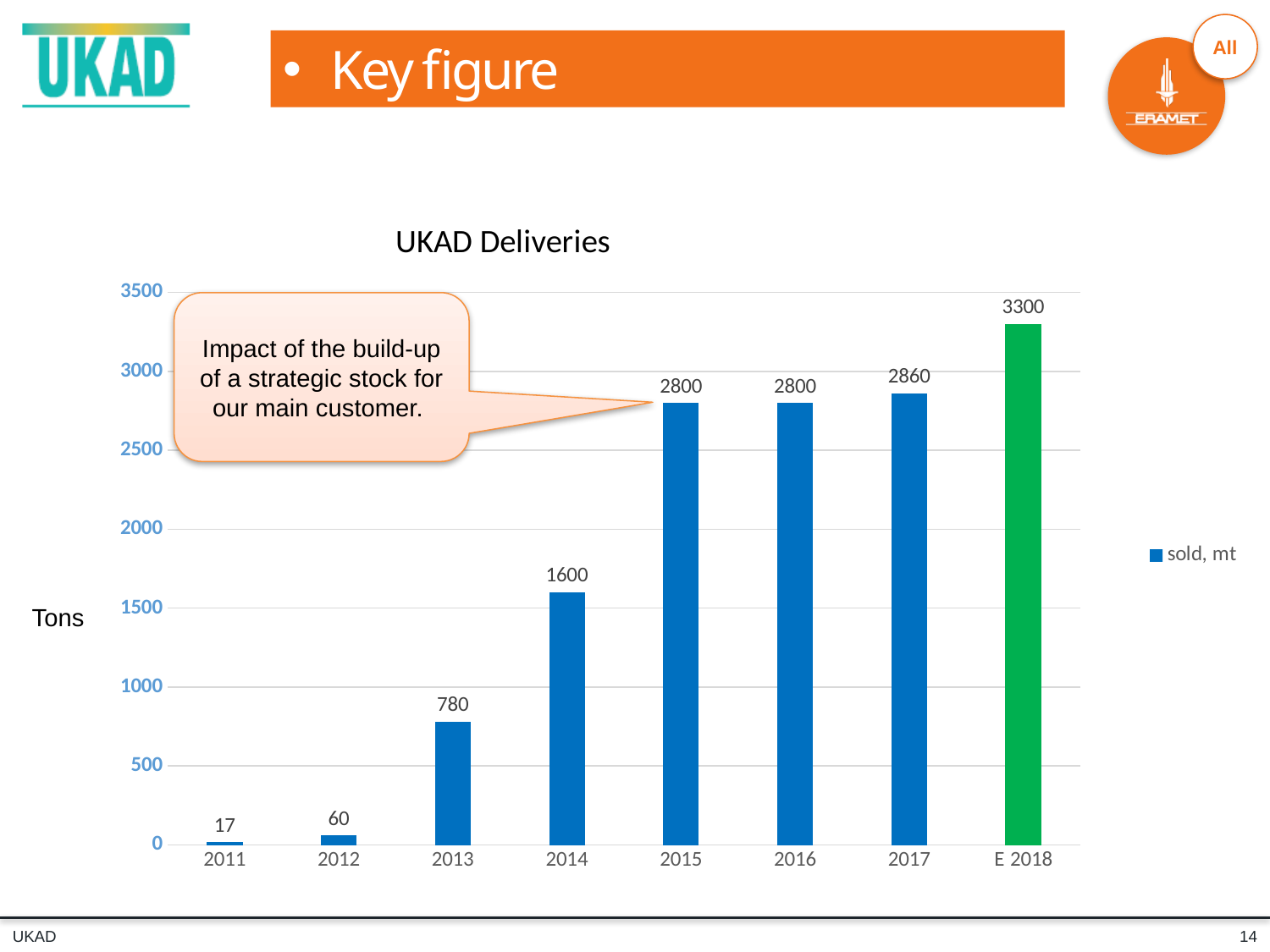
What is the difference between the values for 2014 and 2013 in the UKAD Deliveries chart? 820 Which year has the lowest value in the UKAD Deliveries chart? 2011 How many years are shown on the x axis of the UKAD Deliveries chart? 8 What is the value for 2011 in the UKAD Deliveries chart? 17 What is the difference between the values for E 2018 and 2017 in the UKAD Deliveries chart? 440 What is the value for 2017 in the UKAD Deliveries chart? 2860 What is the value for 2014 in the UKAD Deliveries chart? 1600 Which is larger in the UKAD Deliveries chart, the value for 2013 or the value for 2014? 2014 What kind of chart is the UKAD Deliveries chart? bar chart Which year has the highest value in the UKAD Deliveries chart? E 2018 What is the legend entry in the UKAD Deliveries chart? sold, mt How many series does the legend of the UKAD Deliveries chart list? 1